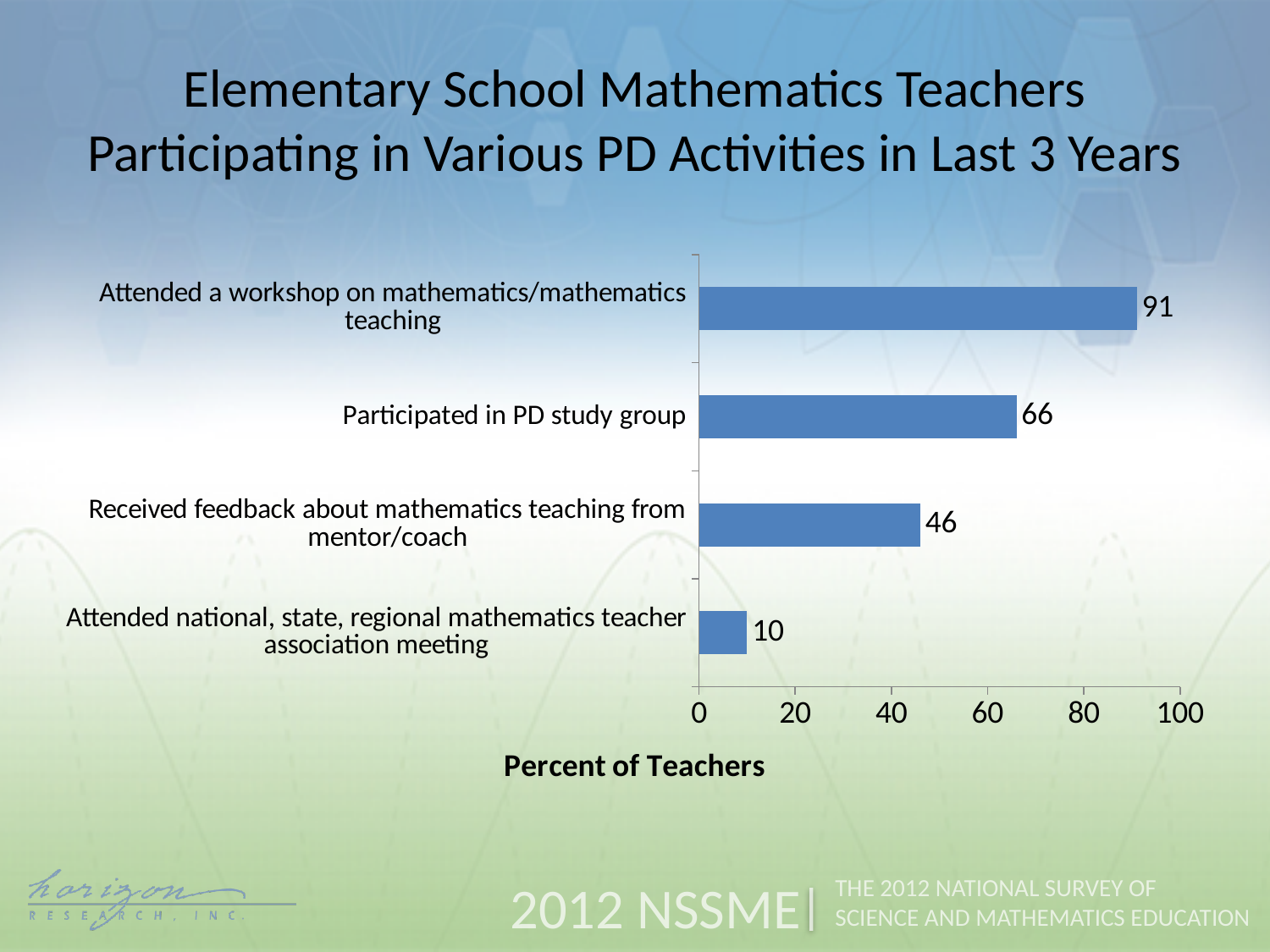
Which PD activity had the highest percent of teachers participating? Attended a workshop on mathematics/mathematics teaching What percent of teachers attended a national, state, regional mathematics teacher association meeting? 10 How many PD activities are shown in the chart? 4 What is the difference in percent between teachers who received feedback from a mentor/coach and those who attended a teacher association meeting? 36 What is the label of the horizontal axis? Percent of Teachers What is the difference in percent between teachers who attended a workshop and those who participated in a PD study group? 25 What percent of teachers participated in a PD study group? 66 What percent of elementary school mathematics teachers attended a workshop on mathematics/mathematics teaching? 91 Which PD activity had the lowest percent of teachers participating? Attended national, state, regional mathematics teacher association meeting What percent of teachers received feedback about mathematics teaching from a mentor/coach? 46 What type of chart is shown on the slide? Bar chart Which had a higher percent of teachers: participating in a PD study group or receiving feedback from a mentor/coach? Participated in PD study group